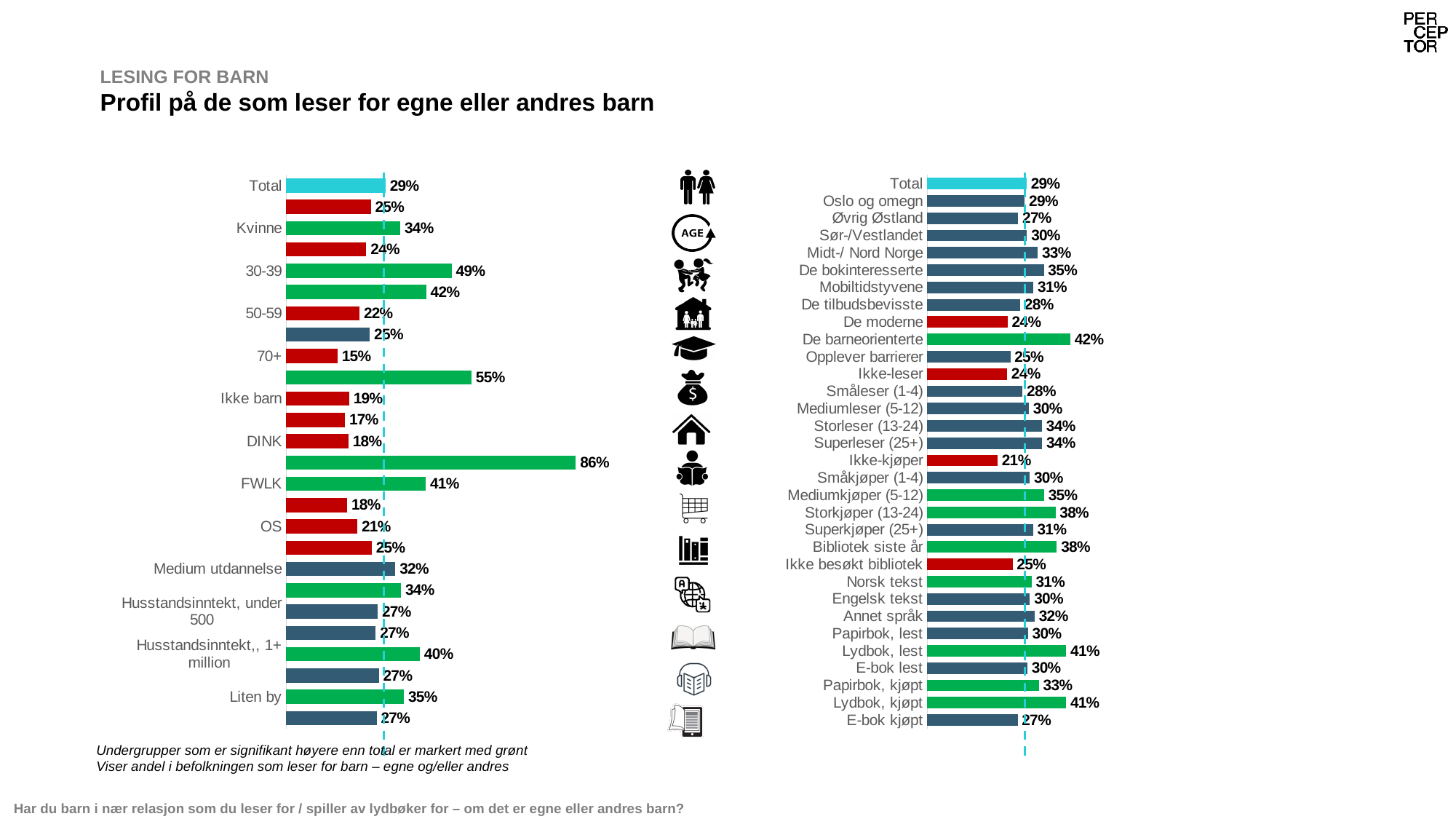
In the left chart, which labeled category has the lowest value? 70+ In the right chart, which category has the highest value? De barneorienterte In the left chart, which is larger: Husstandsinntekt, 1+ million or Liten by? Husstandsinntekt, 1+ million What kind of chart is shown on the right side of the slide? Bar chart In the right chart, what is the difference between Storkjøper (13-24) and Ikke-kjøper? 17% In the right chart, which category has the lowest value? Ikke-kjøper In the left chart, what is the difference between Kvinne and 50-59? 12% In the left chart, what is the value for 30-39? 49% In the right chart, what is the value for De barneorienterte? 42% In the right chart, what is the value for Lydbok, kjøpt? 41% In the left chart, what is the value for FWLK? 41% In the right chart, how many categories are plotted? 32